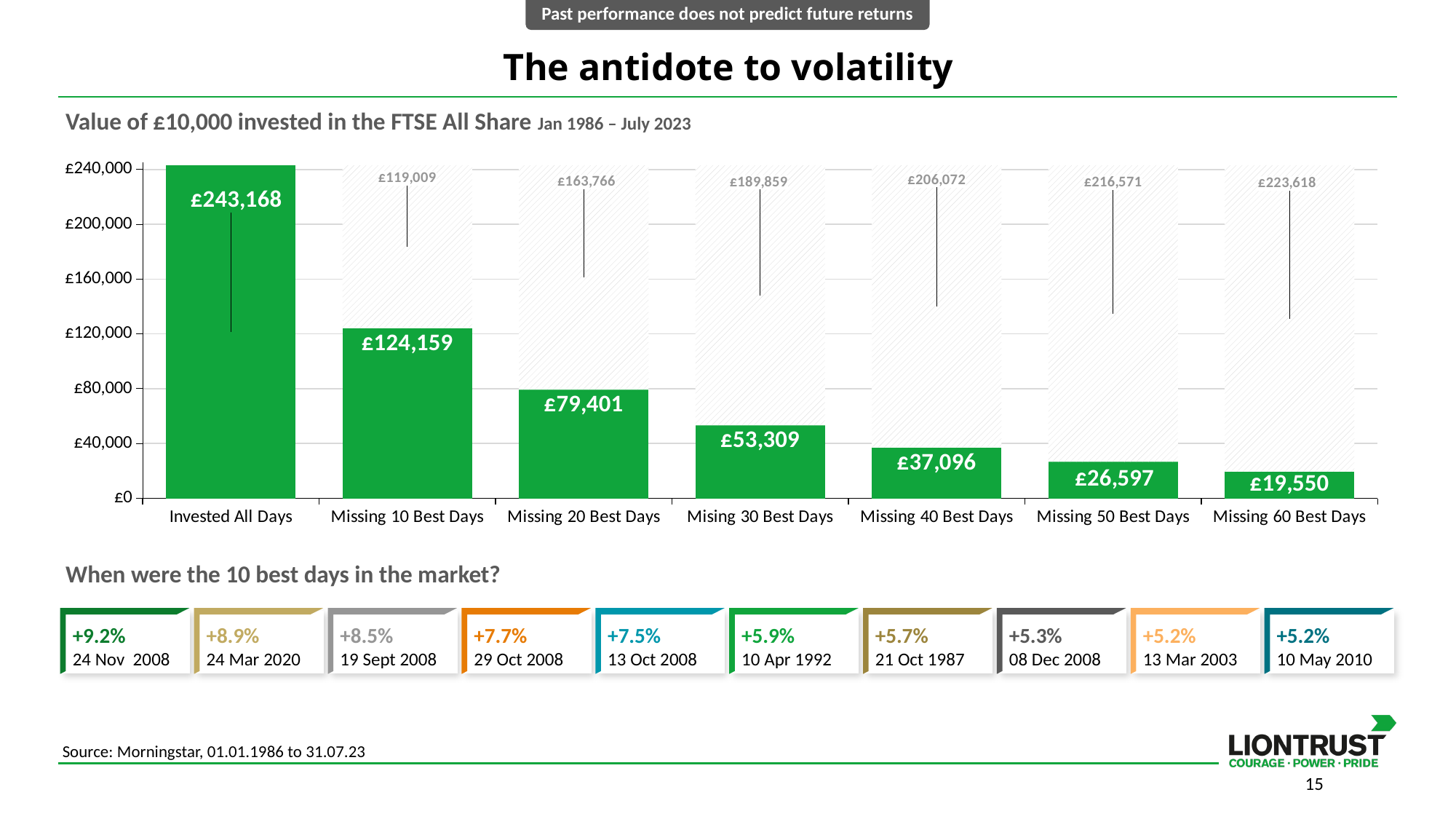
What is the difference between the values for Invested All Days and Missing 10 Best Days? £119,009 Do the bar values rise or fall from left to right along the x axis? Fall What kind of chart is this? Bar chart What is the value shown for Missing 10 Best Days? £124,159 How many categories are shown on the x axis? 7 What is the difference between the values for Missing 50 Best Days and Missing 60 Best Days? £7,047 Which category has the lowest value? Missing 60 Best Days Which category has the highest value? Invested All Days What is the value shown for Missing 40 Best Days? £37,096 What is the value shown for Missing 60 Best Days? £19,550 What is the value shown for Invested All Days? £243,168 Which is larger, the value for Missing 20 Best Days or Mising 30 Best Days? Missing 20 Best Days